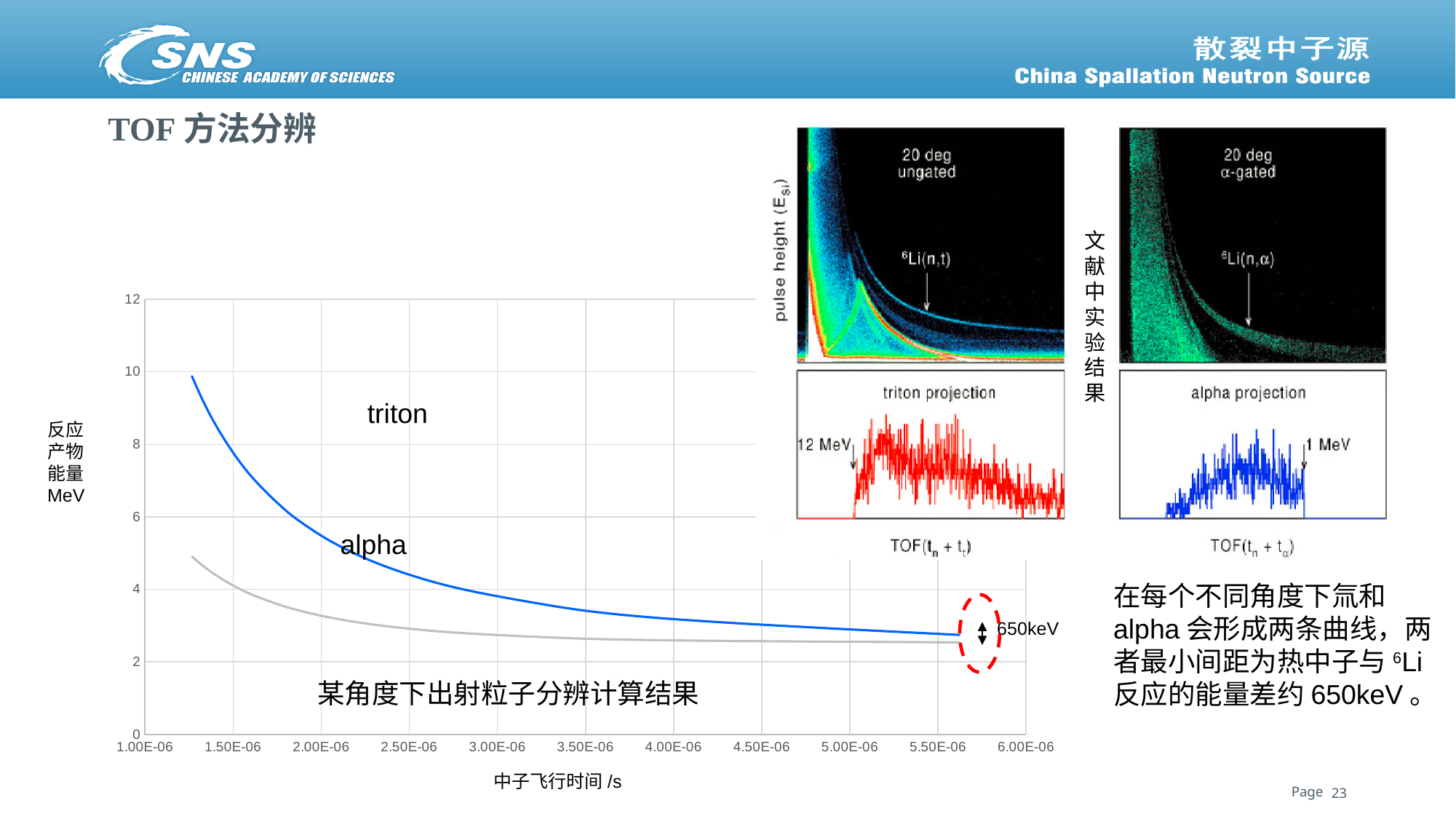
How many curves are plotted in the left chart? 2 What kind of chart is the plot on the left of the slide (with the triton and alpha curves)? line chart In the left chart, is the alpha energy at 2.00E-06 s greater or less than 4 MeV? less What is the x-axis label of the left chart? 中子飞行时间 /s In the left chart, what energy difference between the two curves is annotated at the right end? 650keV In the left chart, which curve starts at the highest energy value? triton In the left chart, is the triton energy at 4.00E-06 s greater or less than 4 MeV? less In the left chart, is the alpha energy at 5.00E-06 s greater or less than 2 MeV? greater In the left chart, do the curves rise or fall as neutron flight time increases? fall In the left chart, which curve has the higher energy at a given flight time, triton or alpha? triton In the left chart, what are the two curves labelled? triton and alpha